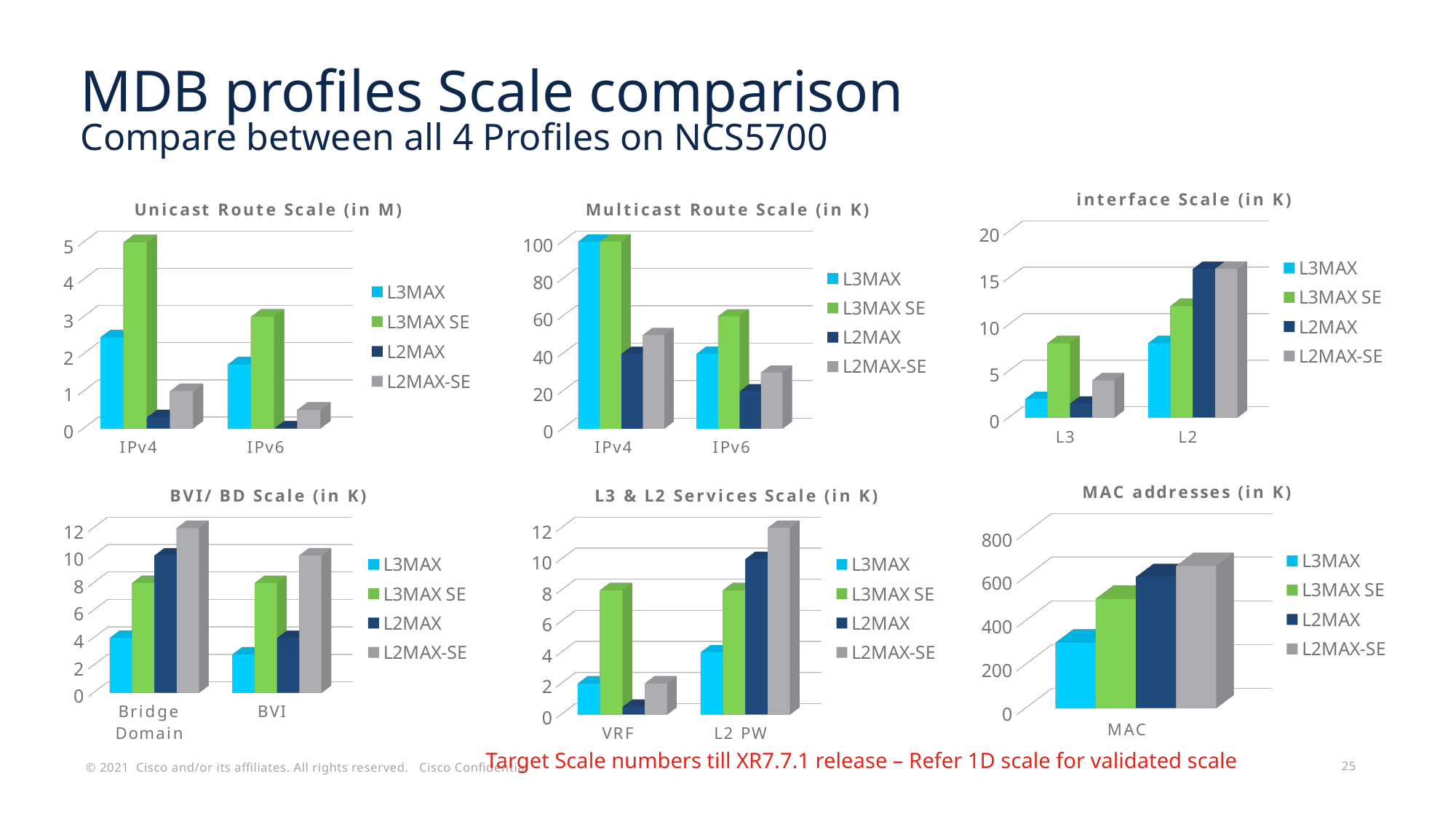
In the L3 & L2 Services Scale (in K) chart, is the L2MAX-SE value for L2 PW greater or less than 10? greater In the Multicast Route Scale (in K) chart, is the L2MAX value for IPv6 greater or less than 40? less In the BVI/ BD Scale (in K) chart, which series has the highest value for Bridge Domain? L2MAX-SE In the L3 & L2 Services Scale (in K) chart, which series has the lowest value for VRF? L2MAX In the MAC addresses (in K) chart, which series has the lowest value? L3MAX In the interface Scale (in K) chart, which series has the highest value for L3? L3MAX SE In the Unicast Route Scale (in M) chart, which series has the highest value for IPv4? L3MAX SE How many series does the legend of the Unicast Route Scale (in M) chart list? 4 In the Unicast Route Scale (in M) chart, is the L3MAX value for IPv4 greater or less than 2? greater In the BVI/ BD Scale (in K) chart, which is larger for Bridge Domain: L3MAX or L3MAX SE? L3MAX SE In the Multicast Route Scale (in K) chart, how many categories are shown on the x axis? 2